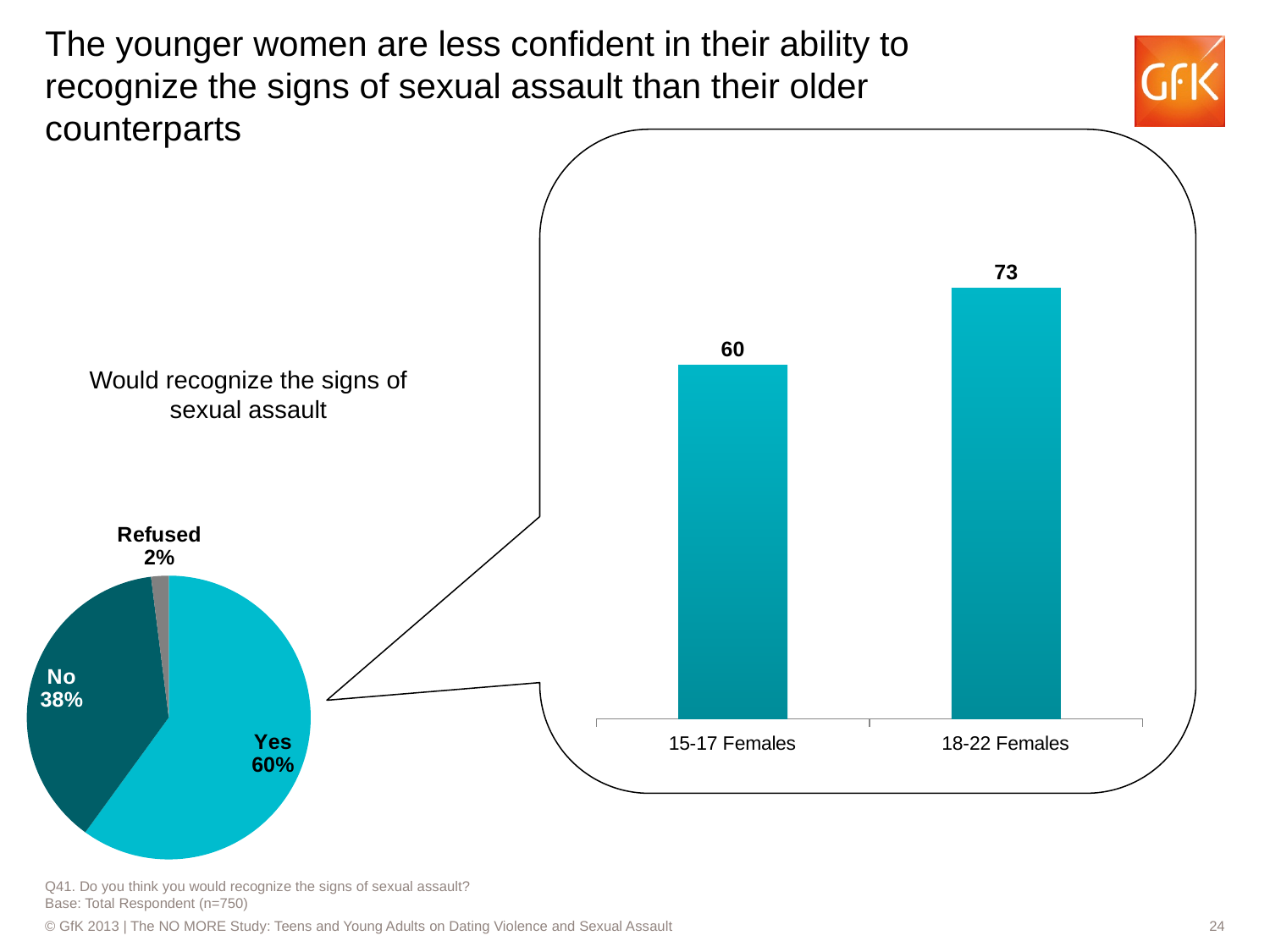
In the bar chart on the right, which group has the higher value? 18-22 Females In the bar chart on the right, what is the value for 15-17 Females? 60 In the bar chart on the right, what is the difference between the values for 18-22 Females and 15-17 Females? 13 In the pie chart on the left, what share of respondents answered Yes? 60% How many categories are shown in the bar chart on the right? 2 What kind of chart is shown on the right side of the slide? Bar chart In the pie chart on the left, what share of respondents answered No? 38% In the pie chart on the left, which slice is the largest? Yes In the pie chart on the left, what share of respondents refused to answer? 2% How many slices does the pie chart on the left have? 3 In the pie chart on the left, which slice is the smallest? Refused In the bar chart on the right, what is the value for 18-22 Females? 73